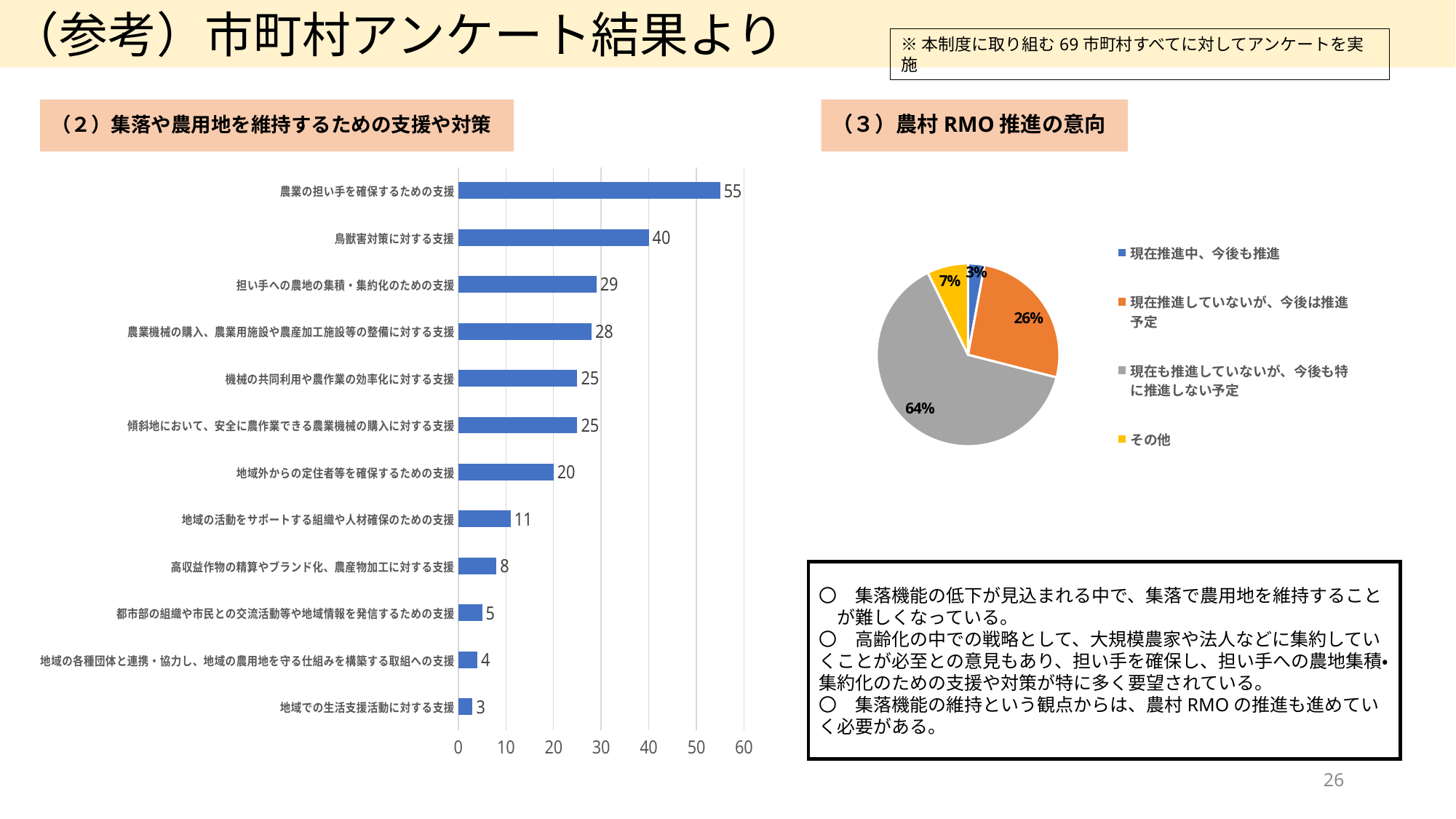
In the pie chart on the right, what share is labelled for 現在推進していないが、今後は推進予定? 26% How many categories are shown in the bar chart on the left? 12 How many entries does the legend of the pie chart on the right list? 4 In the bar chart on the left, what is the difference between the values for 農業の担い手を確保するための支援 and 鳥獣害対策に対する支援? 15 In the bar chart on the left, which category has the lowest value? 地域での生活支援活動に対する支援 In the bar chart on the left (（２）集落や農用地を維持するための支援や対策), what is the value for 農業の担い手を確保するための支援? 55 In the pie chart on the right, which slice is the smallest? 現在推進中、今後も推進 In the pie chart on the right (（３）農村RMO推進の意向), what share is labelled for 現在も推進していないが、今後も特に推進しない予定? 64% What kind of chart is shown on the left side of the slide? Bar chart In the bar chart on the left, which category has the highest value? 農業の担い手を確保するための支援 In the bar chart on the left, which is larger: the value for 担い手への農地の集積・集約化のための支援 or the value for 地域外からの定住者等を確保するための支援? 担い手への農地の集積・集約化のための支援 In the bar chart on the left, what is the value for 鳥獣害対策に対する支援? 40